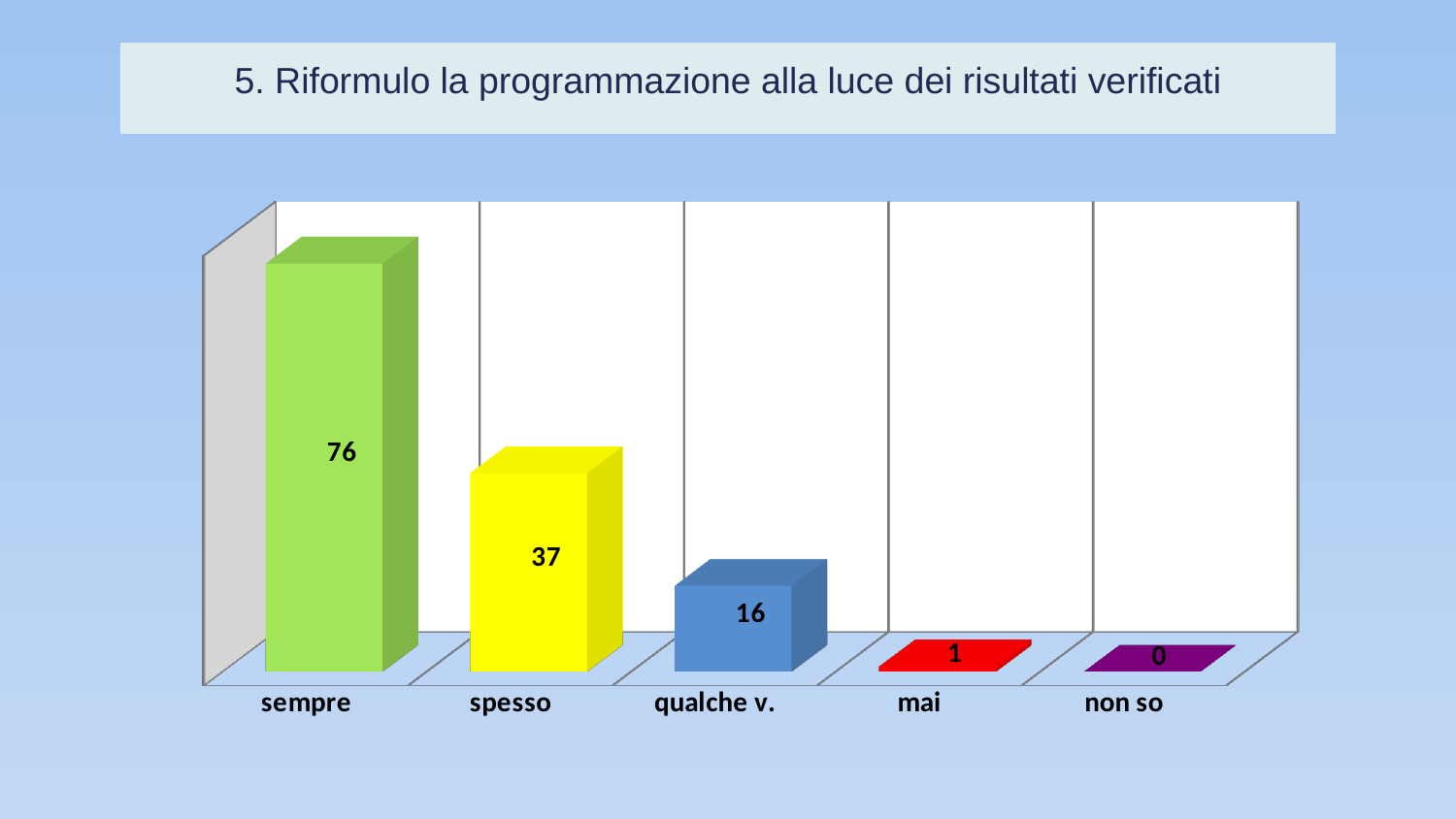
What kind of chart is shown on the slide? bar chart Which category has the lowest value? non so What is the value for "spesso"? 37 Which category has the highest value? sempre What is the difference between the values for "sempre" and "spesso"? 39 What is the value for "non so"? 0 What is the value for "sempre"? 76 Do the values rise or fall from left to right along the x axis? fall Which is larger, the value for "spesso" or the value for "qualche v."? spesso What is the value for "mai"? 1 What is the value for "qualche v."? 16 How many categories are shown on the x axis? 5